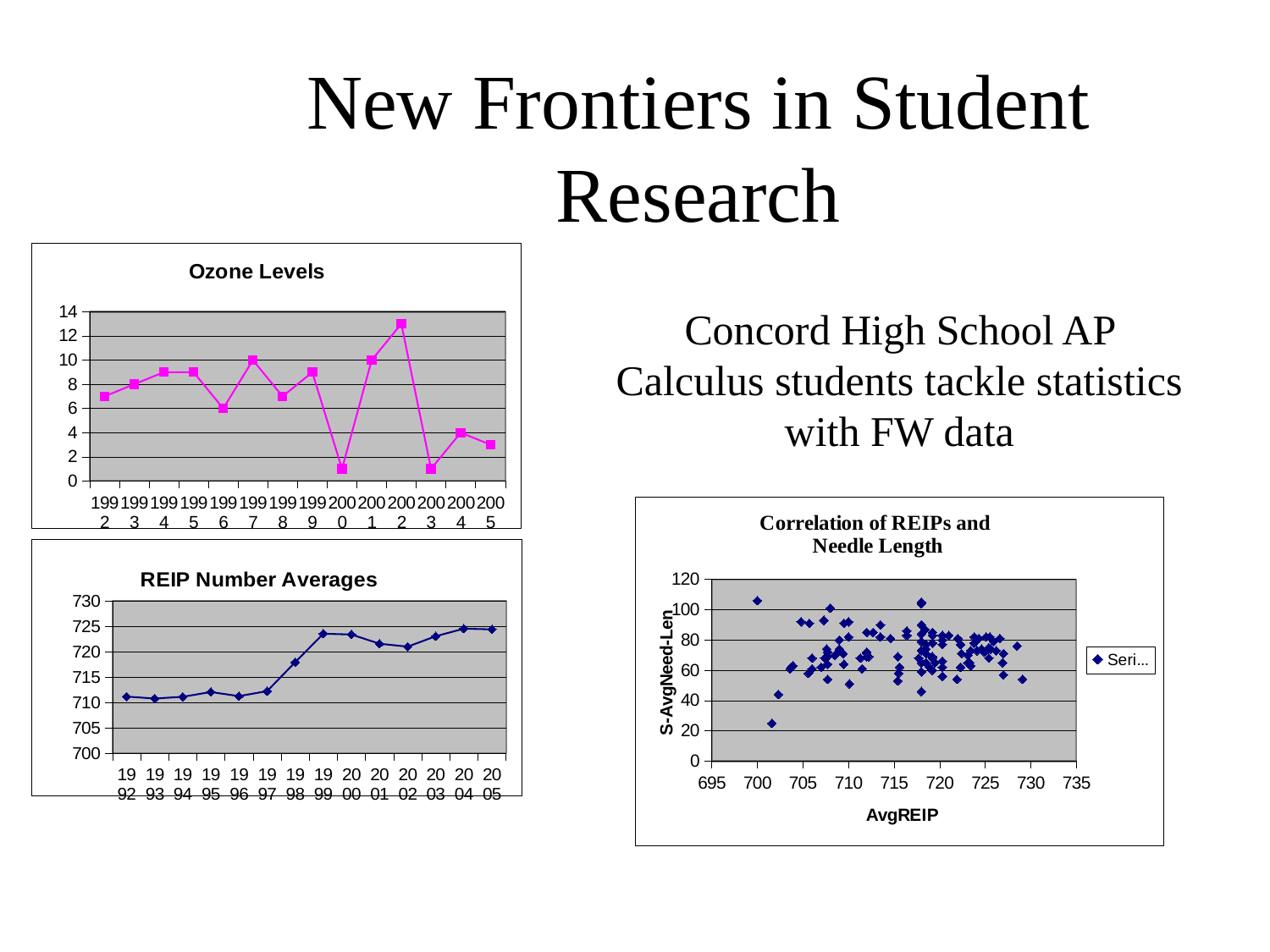
What kind of chart is the "Ozone Levels" chart? line chart On the "REIP Number Averages" chart, do the values generally rise or fall from 1992 to 2005? rise On the "Ozone Levels" chart, is the value for 2002 greater or less than 12? greater On the "REIP Number Averages" chart, is the value for 1992 greater or less than 715? less What kind of chart is the "REIP Number Averages" chart? line chart On the "Ozone Levels" chart, what is the value for 1996? 6 On the "Correlation of REIPs and Needle Length" chart, what is the title of the horizontal axis? AvgREIP On the "Ozone Levels" chart, which year has the highest ozone level? 2002 On the "Ozone Levels" chart, is the value for 2000 greater or less than 2? less How many years are plotted on the "Ozone Levels" chart? 14 On the "Ozone Levels" chart, what is the value for 1997? 10 On the "Ozone Levels" chart, which year has the higher value, 2001 or 2003? 2001